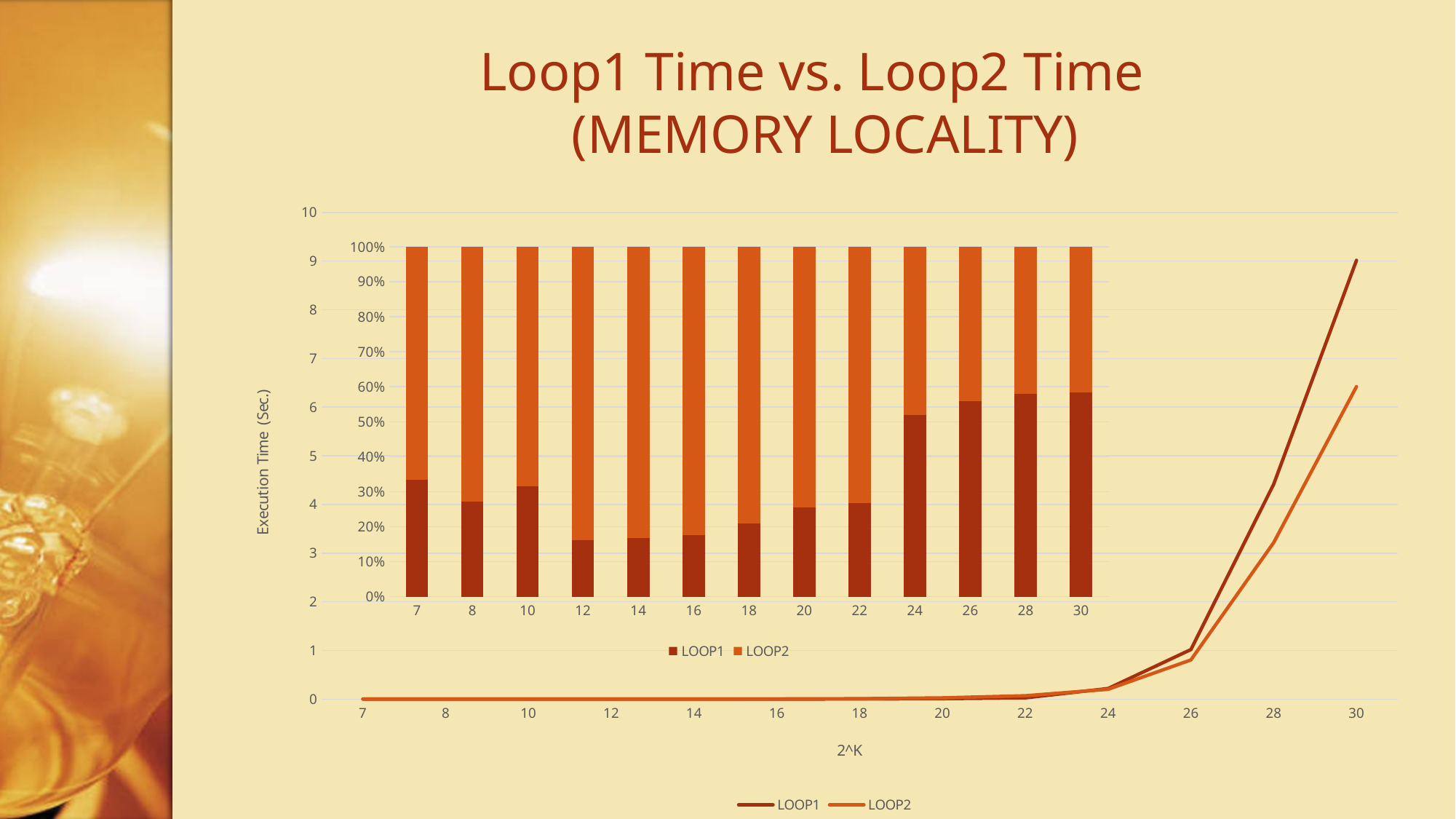
How many data points does each series in the line chart have? 13 How many series does the legend of the line chart list? 2 What kind of chart is the inset chart with the percentage axis? stacked bar chart In the inset stacked bar chart, is the LOOP1 share at 30 greater or less than 50%? greater In the line chart, is the LOOP2 value at 30 greater or less than 7? less In the line chart, is the LOOP1 value at 28 greater or less than 4? greater In the line chart, do the LOOP1 values rise or fall as 2^K increases from 24 to 30? rise In the line chart, which series has the larger value at 30, LOOP1 or LOOP2? LOOP1 What kind of chart is the large chart with the x axis labelled 2^K? line chart In the inset stacked bar chart, which has the larger LOOP1 share, 7 or 12? 7 How many bars are in the inset stacked bar chart? 13